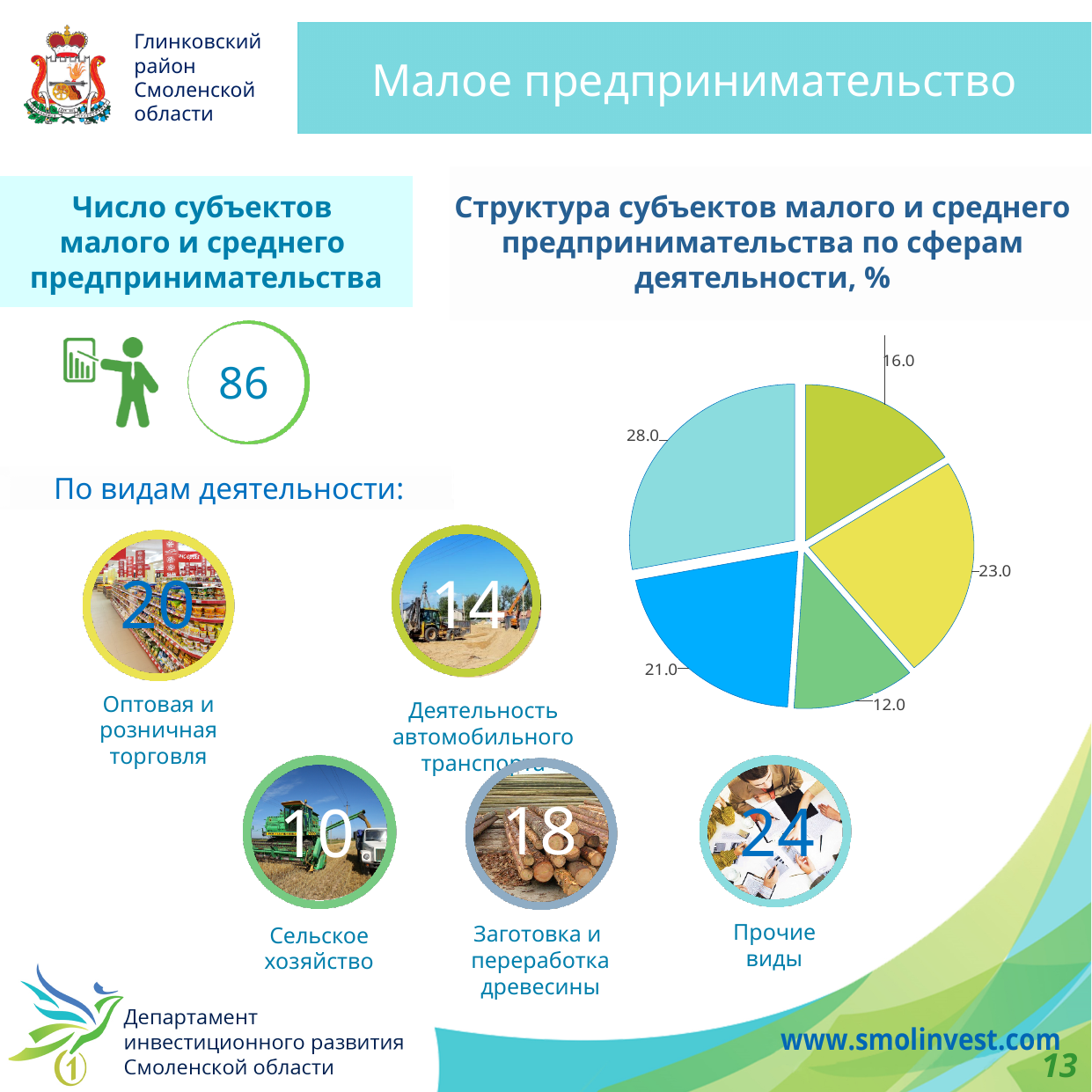
What value is labelled on the dark blue slice of the pie chart? 21.0 What is the value of the smallest slice in the pie chart? 12.0 How many slices does the pie chart have? 5 How many slices in the pie chart have a value greater than 20.0? 3 What kind of chart is shown under the title "Структура субъектов малого и среднего предпринимательства по сферам деятельности, %"? pie chart What is the value of the largest slice in the pie chart? 28.0 What is the difference between the largest and smallest slice values in the pie chart? 16.0 What do all the slice values in the pie chart add up to? 100.0 What is the difference between the slice labelled 23.0 and the slice labelled 21.0 in the pie chart? 2.0 What value is labelled on the light blue slice of the pie chart? 28.0 Which slice is larger in the pie chart, the yellow one or the dark blue one? the yellow one What is the title of the pie chart on the slide? Структура субъектов малого и среднего предпринимательства по сферам деятельности, %